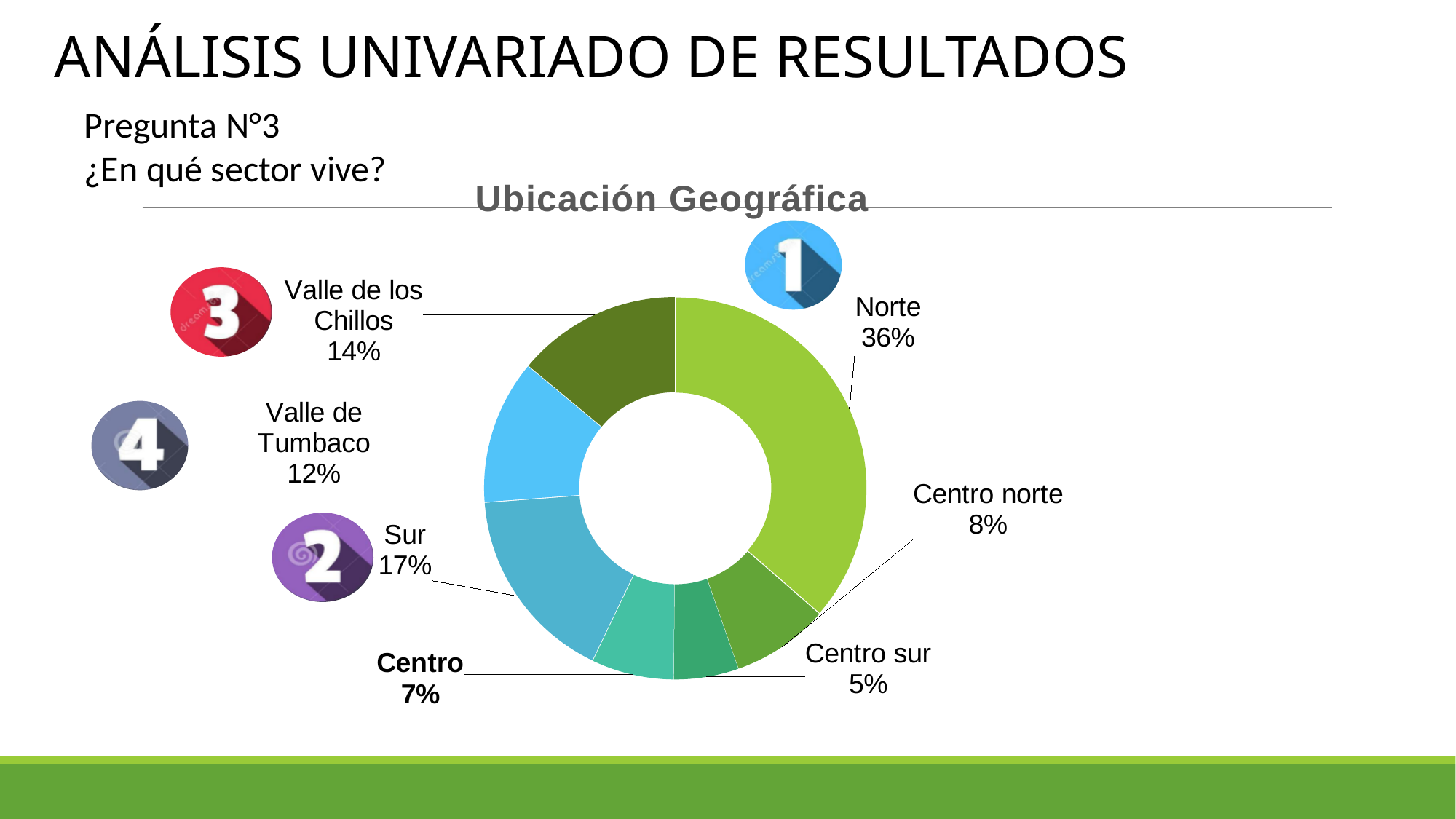
What percentage of respondents live in Valle de Tumbaco? 12% What is the difference in percentage points between Norte and Sur? 19 What percentage of respondents live in Norte? 36% Which sector has the smallest share? Centro sur What type of chart is shown on the slide? Doughnut chart Which has a larger share, Valle de los Chillos or Valle de Tumbaco? Valle de los Chillos What percentage of respondents live in Centro sur? 5% What is the title of the chart? Ubicación Geográfica What percentage of respondents live in Sur? 17% What is the combined share of Centro norte, Centro and Centro sur? 20% How many sectors are shown in the chart? 7 Which sector has the largest share? Norte